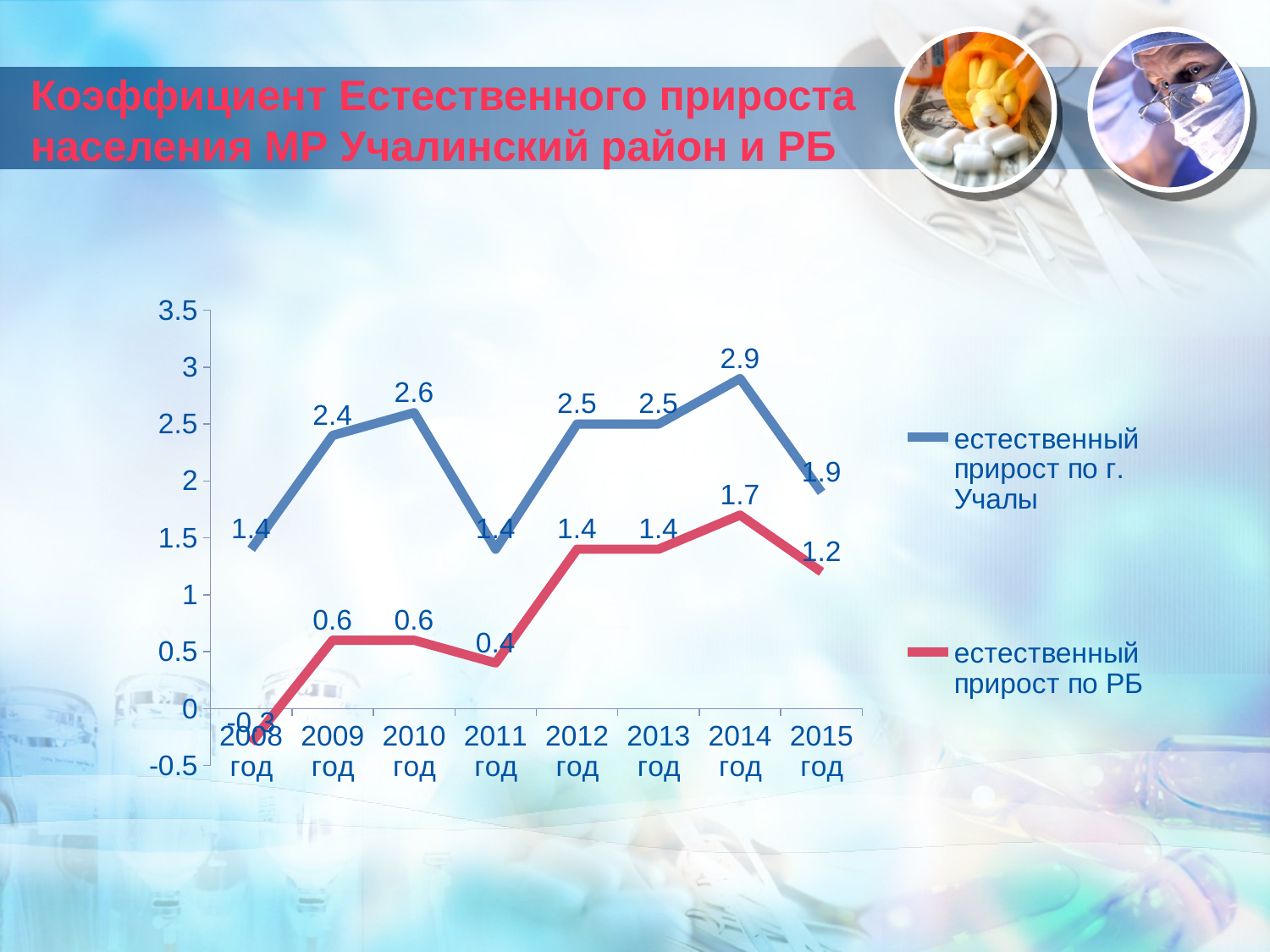
Which is larger in 2012 год: естественный прирост по г. Учалы or естественный прирост по РБ? естественный прирост по г. Учалы Does естественный прирост по г. Учалы rise or fall from 2014 год to 2015 год? fall In which year is естественный прирост по РБ highest? 2014 год What colour is the line for естественный прирост по РБ? red What is the difference between естественный прирост по г. Учалы and естественный прирост по РБ in 2015 год? 0.7 What is the value for естественный прирост по г. Учалы in 2014 год? 2.9 In which year is естественный прирост по г. Учалы highest? 2014 год What type of chart is shown on the slide? line chart How many years are plotted along the x axis? 8 How many series does the legend list? 2 What is the value for естественный прирост по РБ in 2011 год? 0.4 What is the value for естественный прирост по г. Учалы in 2010 год? 2.6